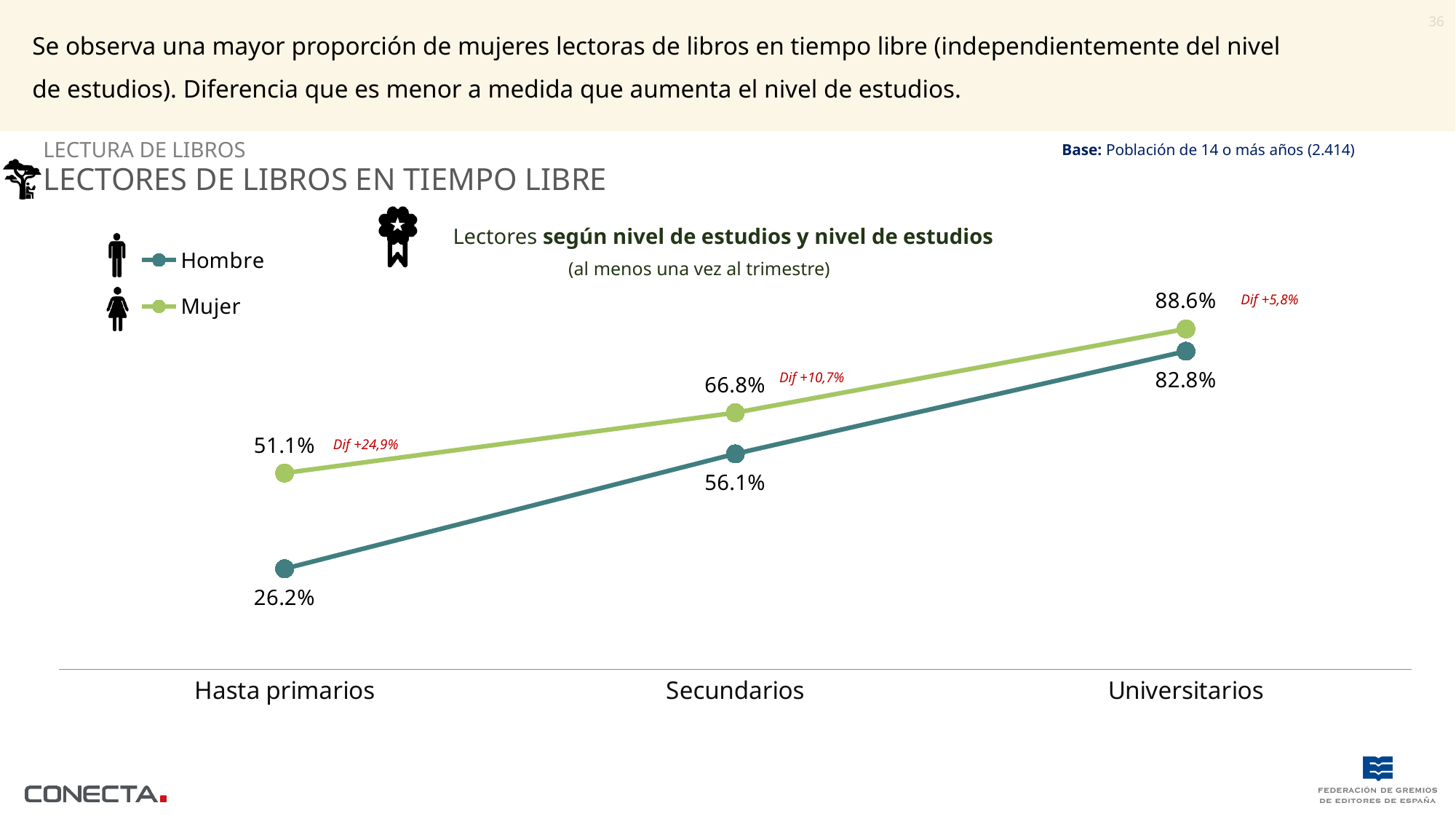
What is the value for Hombre at Universitarios? 82.8% What is the value for Mujer at Hasta primarios? 51.1% Which education level has the highest value for Mujer? Universitarios What kind of chart is this? Line chart Which is larger at Secundarios, Hombre or Mujer? Mujer Which education level has the lowest value for Hombre? Hasta primarios How many series does the legend list? 2 How many education levels are shown on the x axis? 3 What is the value for Hombre at Secundarios? 56.1% What is the value for Mujer at Universitarios? 88.6% What is the difference between Mujer and Hombre at Hasta primarios? 24.9% Do the values for Hombre rise or fall from Hasta primarios to Universitarios? Rise